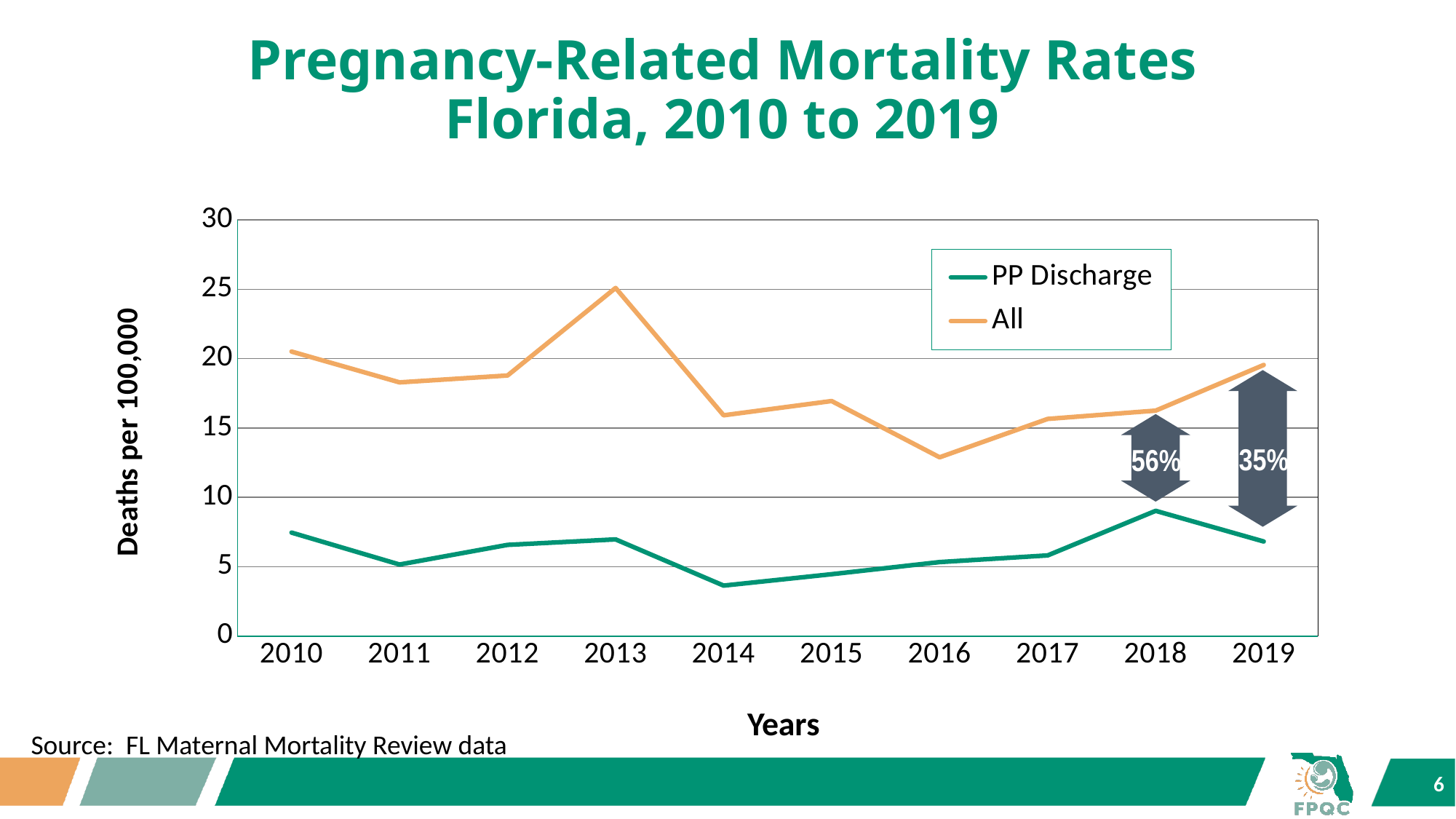
How many years are plotted along the x axis? 10 Which is larger, the All value in 2013 or the All value in 2010? 2013 Is the value for All in 2013 greater or less than 20? greater How many series does the legend list? 2 Is the value for All in 2016 greater or less than 15? less Is the value for PP Discharge in 2014 greater or less than 5? less What kind of chart is shown on the slide? Line chart In which year is the PP Discharge series at its lowest? 2014 In which year is the All series at its lowest? 2016 Does the All series rise or fall from 2016 to 2019? Rise In which year is the PP Discharge series at its highest? 2018 In which year is the All series at its highest? 2013